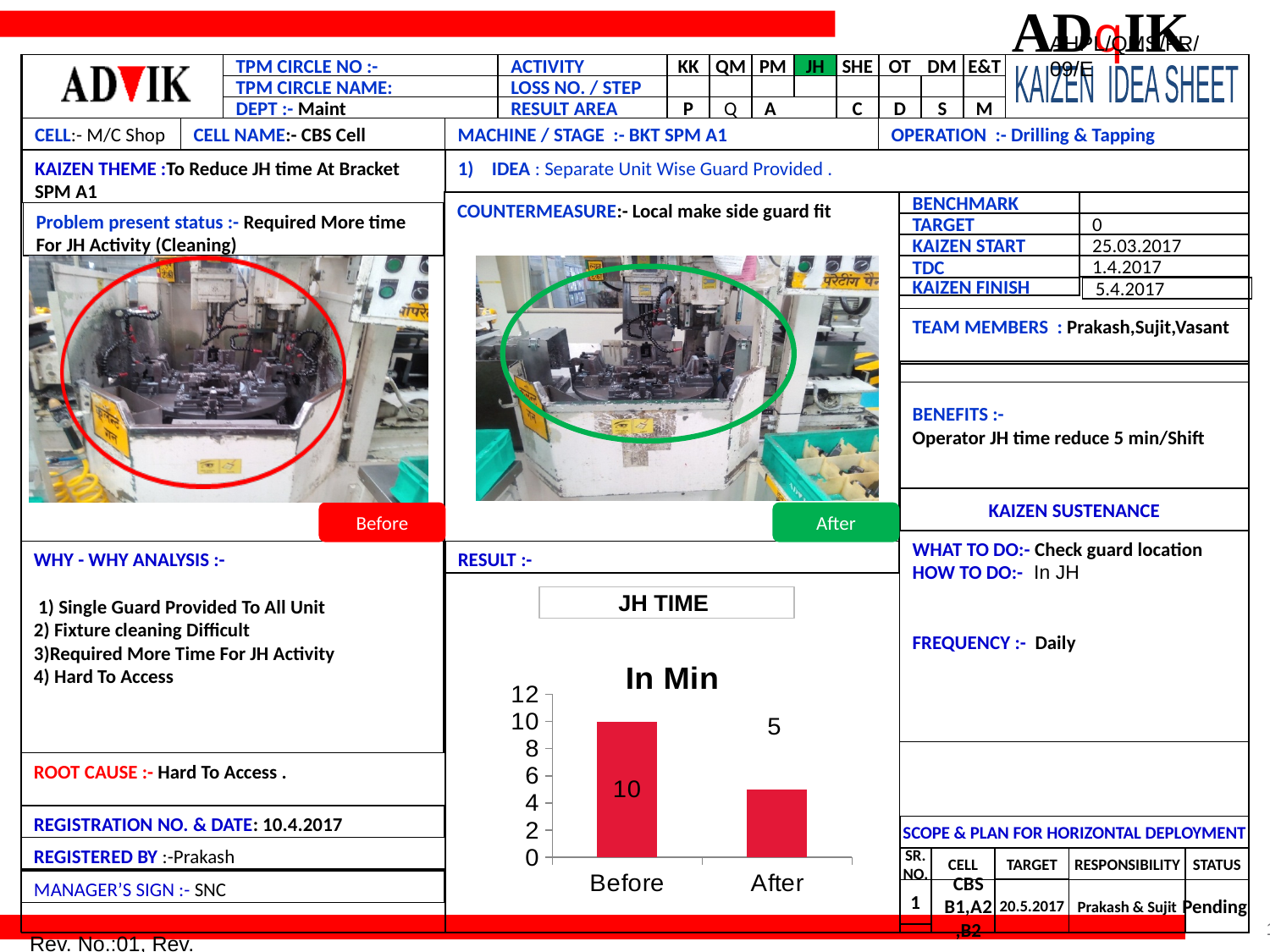
Which category has the lowest value in the JH TIME chart? After Do the values in the JH TIME chart rise or fall from Before to After? fall Is the value for Before in the JH TIME chart greater or less than 8? greater Which is larger in the JH TIME chart, the Before value or the After value? Before How many categories are shown on the x axis of the JH TIME chart? 2 Is the value for After in the JH TIME chart greater or less than 6? less What kind of chart is the JH TIME chart? bar chart Which category has the highest value in the JH TIME chart? Before What is the difference between the Before and After values in the JH TIME chart? 5 What unit label is shown above the bars in the JH TIME chart? In Min What is the value for Before in the JH TIME chart? 10 What is the value for After in the JH TIME chart? 5